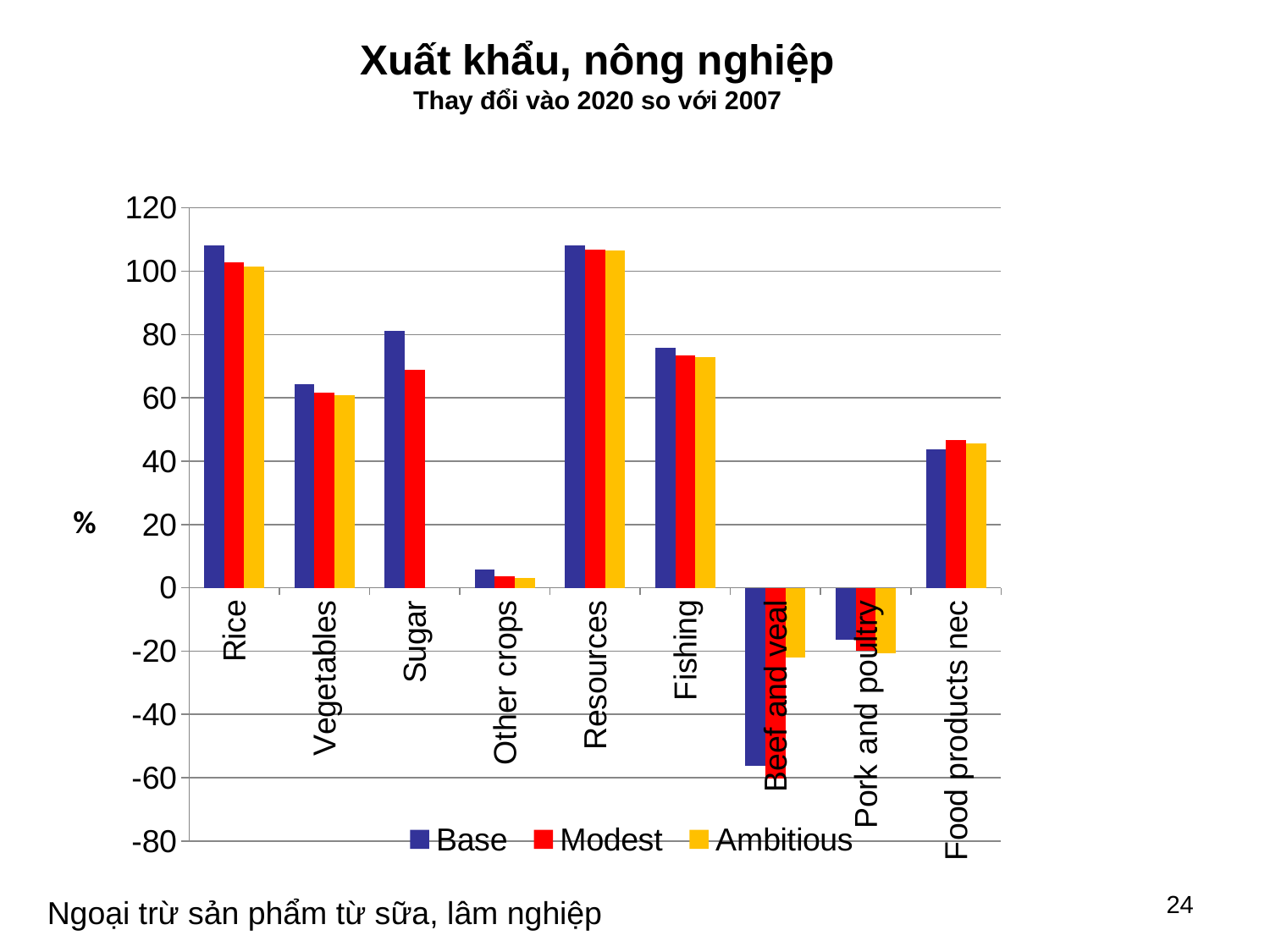
How many series does the legend list? 3 Which is larger for Sugar, the Base value or the Modest value? Base Is the Base value for Beef and veal greater or less than -40? less Which category has the lowest Base value? Beef and veal Is the Base value for Rice greater or less than 100? greater How many categories are shown on the x axis? 9 Which category has the lowest Modest value? Beef and veal Is the Modest value for Food products nec greater or less than 40? greater What kind of chart is shown on the slide? bar chart Which colour represents the Ambitious series in the legend? yellow Which is larger, the Base value for Fishing or the Base value for Vegetables? Fishing